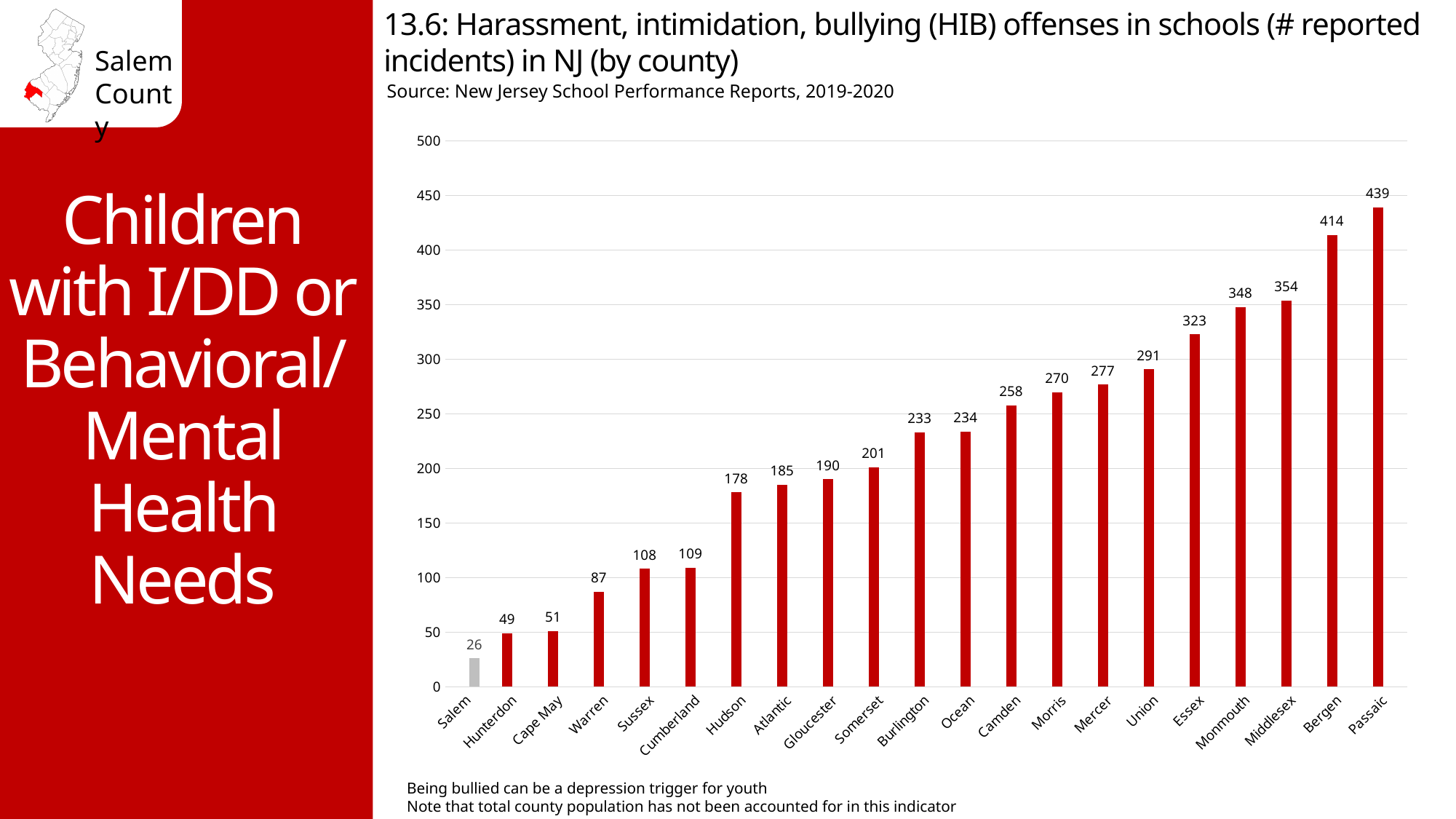
What is the difference in reported HIB incidents between Middlesex and Monmouth? 6 How many counties are shown on the chart? 21 Do the values rise or fall moving from left to right along the x axis? Rise Which county has the highest number of reported HIB incidents? Passaic What type of chart is shown on the slide? Bar chart Which county has the lowest number of reported HIB incidents? Salem Is the value for Union greater or less than 250? greater What is the number of reported HIB incidents for Salem county? 26 What is the number of reported HIB incidents for Camden county? 258 What is the number of reported HIB incidents for Bergen county? 414 Which county has more reported HIB incidents, Hudson or Essex? Essex What is the difference in reported HIB incidents between Passaic and Salem? 413